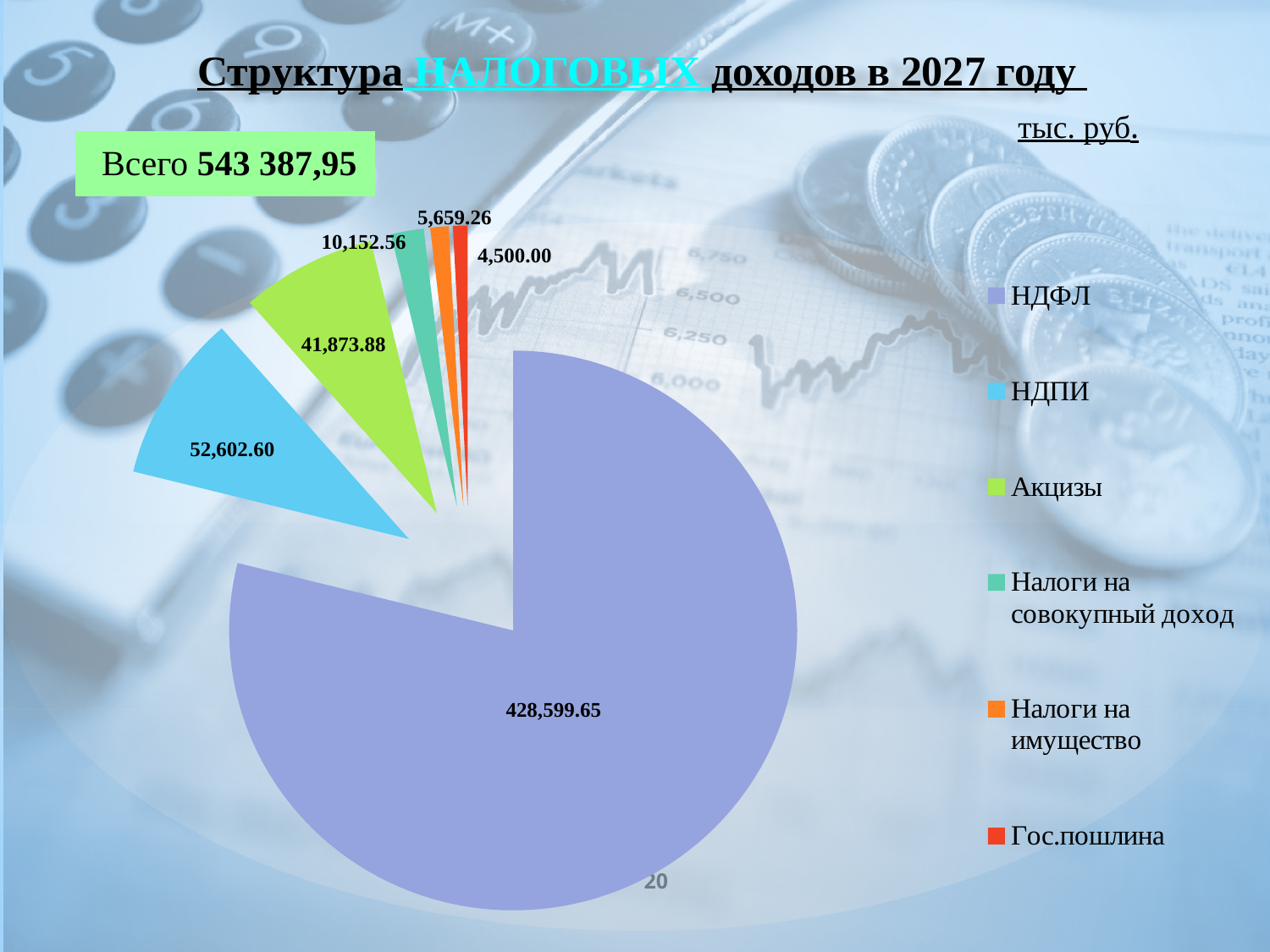
What is the value for Акцизы? 41,873.88 What is the difference between the values for НДПИ and Акцизы? 10,728.72 Which is larger, Налоги на имущество or Гос.пошлина? Налоги на имущество Which category has the largest slice of the pie? НДФЛ What is the value for НДФЛ? 428,599.65 What is the value for НДПИ? 52,602.60 What is the value for Гос.пошлина? 4,500.00 What type of chart is shown on the slide? pie chart What is the value for Налоги на совокупный доход? 10,152.56 How many categories does the legend list? 6 Which category has the smallest slice of the pie? Гос.пошлина What colour is the slice for Акцизы? green